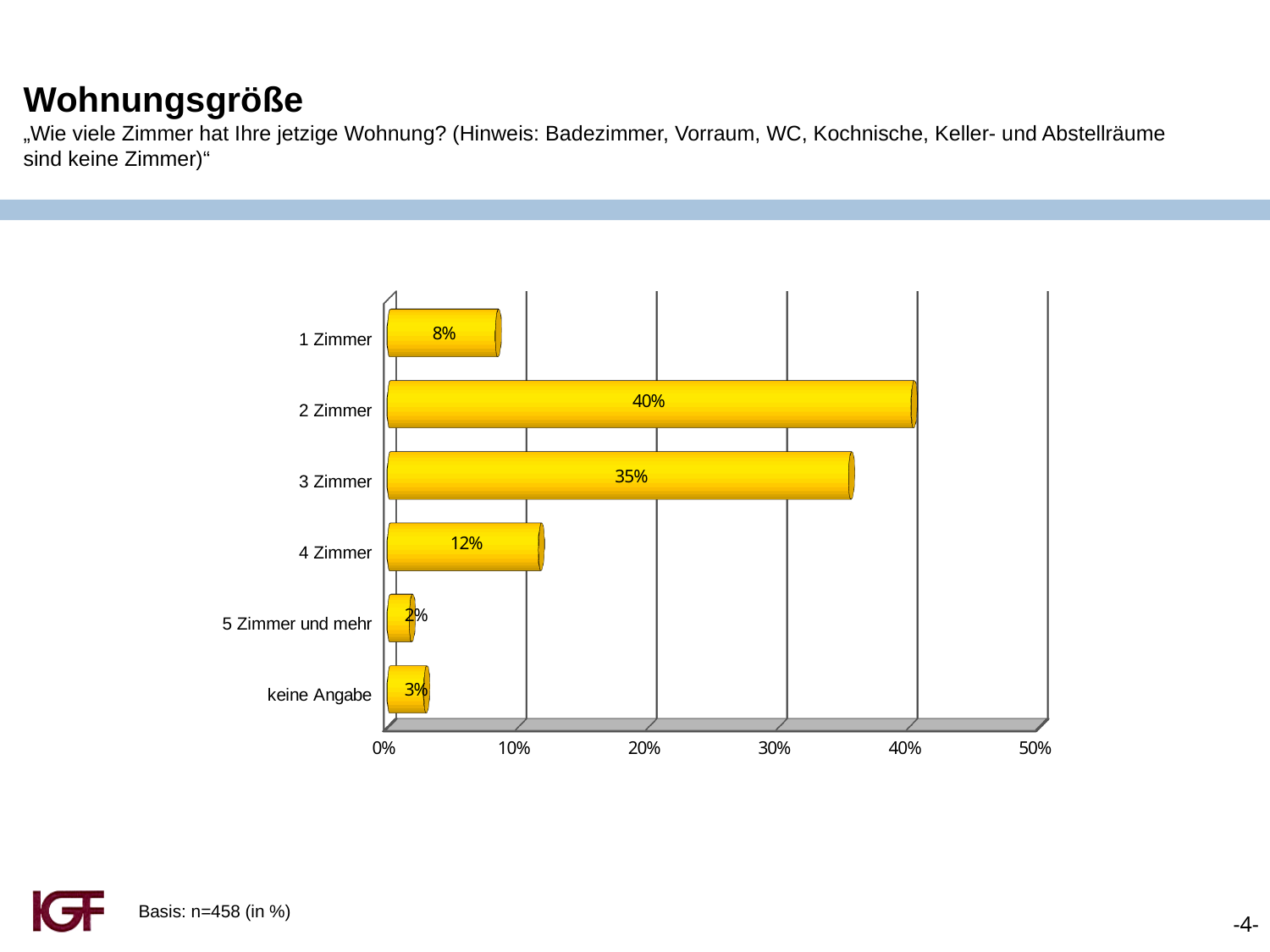
What is the difference between the values for 4 Zimmer and 1 Zimmer? 4% Which category has the lowest value? 5 Zimmer und mehr What is the title of the slide? Wohnungsgröße What is the value for 4 Zimmer? 12% Is the value for 3 Zimmer greater or less than 30%? greater What is the difference between the values for 2 Zimmer and 3 Zimmer? 5% Which category has the highest value? 2 Zimmer Which is larger, the value for 1 Zimmer or the value for 4 Zimmer? 4 Zimmer What is the value for keine Angabe? 3% What is the value for 2 Zimmer? 40% What kind of chart is shown on the slide? bar chart How many categories are shown in the chart? 6